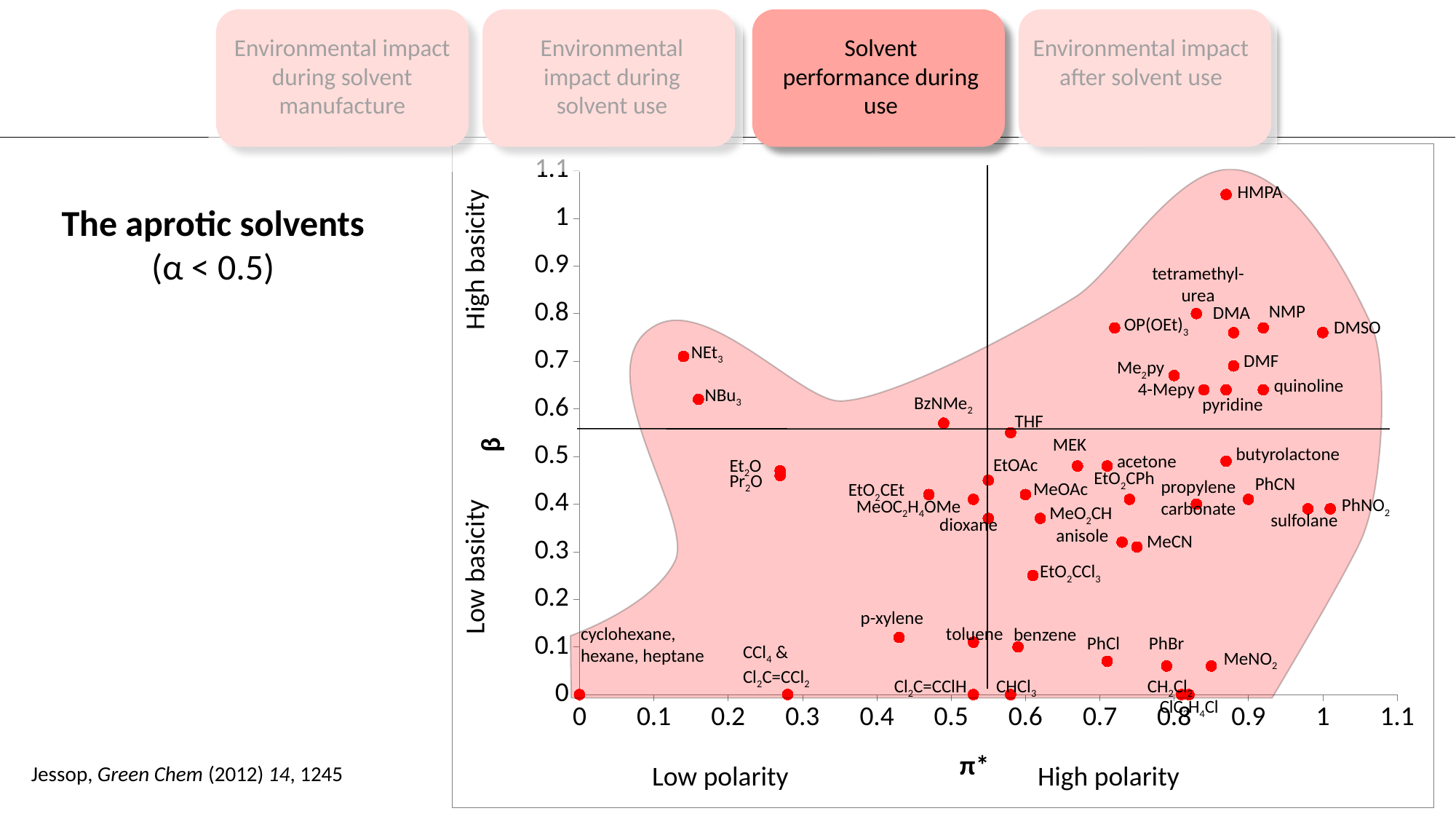
Which has the higher π* value, NEt3 or DMSO? DMSO Which has the higher β value, HMPA or DMSO? HMPA Which has the higher β value, acetone or benzene? acetone Is the π* value for DMSO greater or less than 0.9? greater Is the β value for HMPA greater or less than 1? greater What is the label on the horizontal axis of the chart? π* Is the β value for p-xylene greater or less than 0.2? less What kind of chart is shown on the slide? scatter chart Which solvent has the highest β value on the chart? HMPA